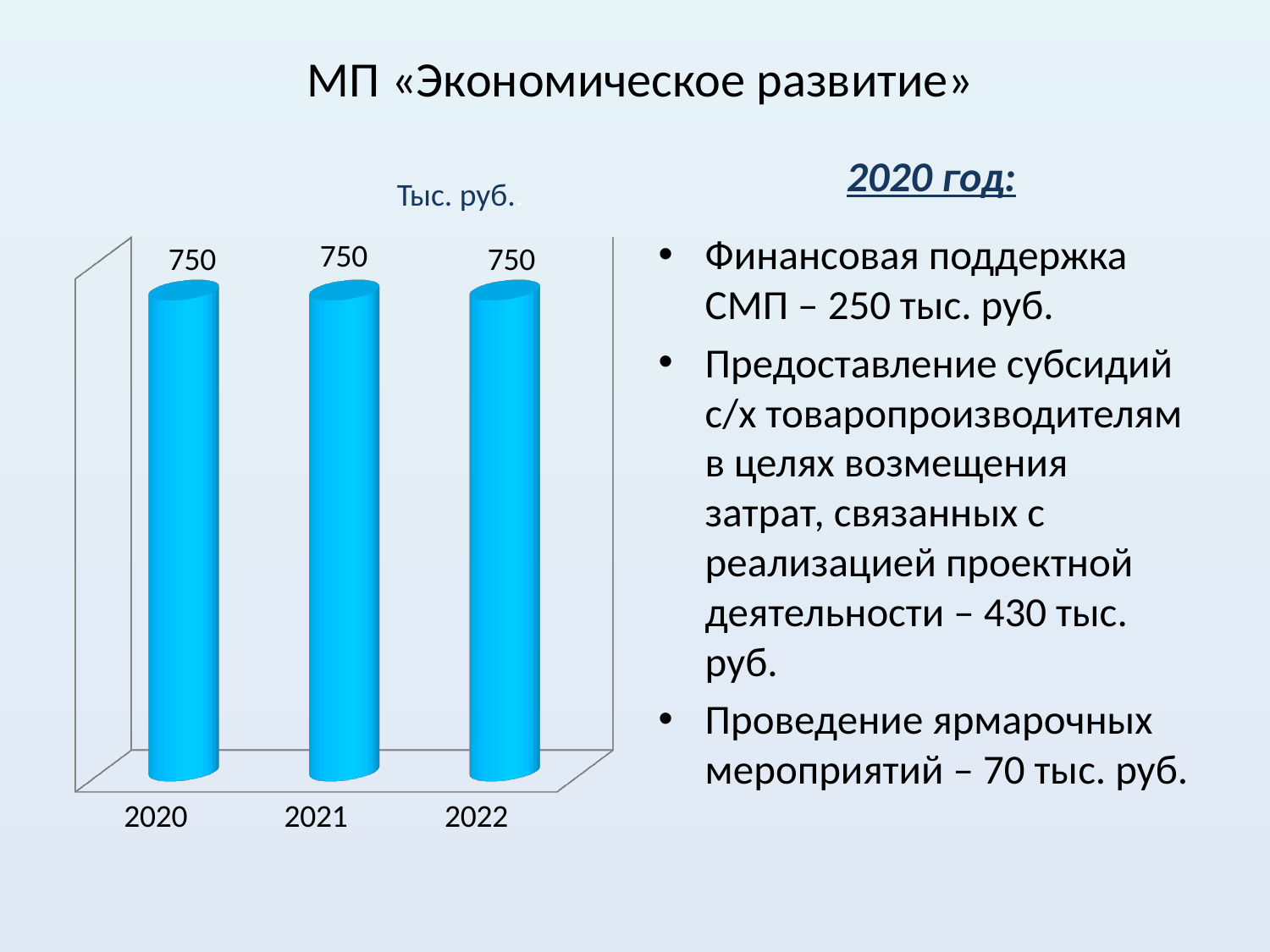
What is the value for 2022 in the chart? 750 What is the difference between the values for 2022 and 2020? 0 Which years are shown on the x axis of the chart? 2020, 2021, 2022 What is the value for 2020 in the chart? 750 What is the value for 2021 in the chart? 750 What is the difference between the values for 2021 and 2020? 0 How many bars (categories) are shown in the chart? 3 What is the title shown above the chart? Тыс. руб. What colour are the bars in the chart? blue What kind of chart is shown on the slide? bar chart Do the values rise, fall, or stay the same from 2020 to 2022? stay the same